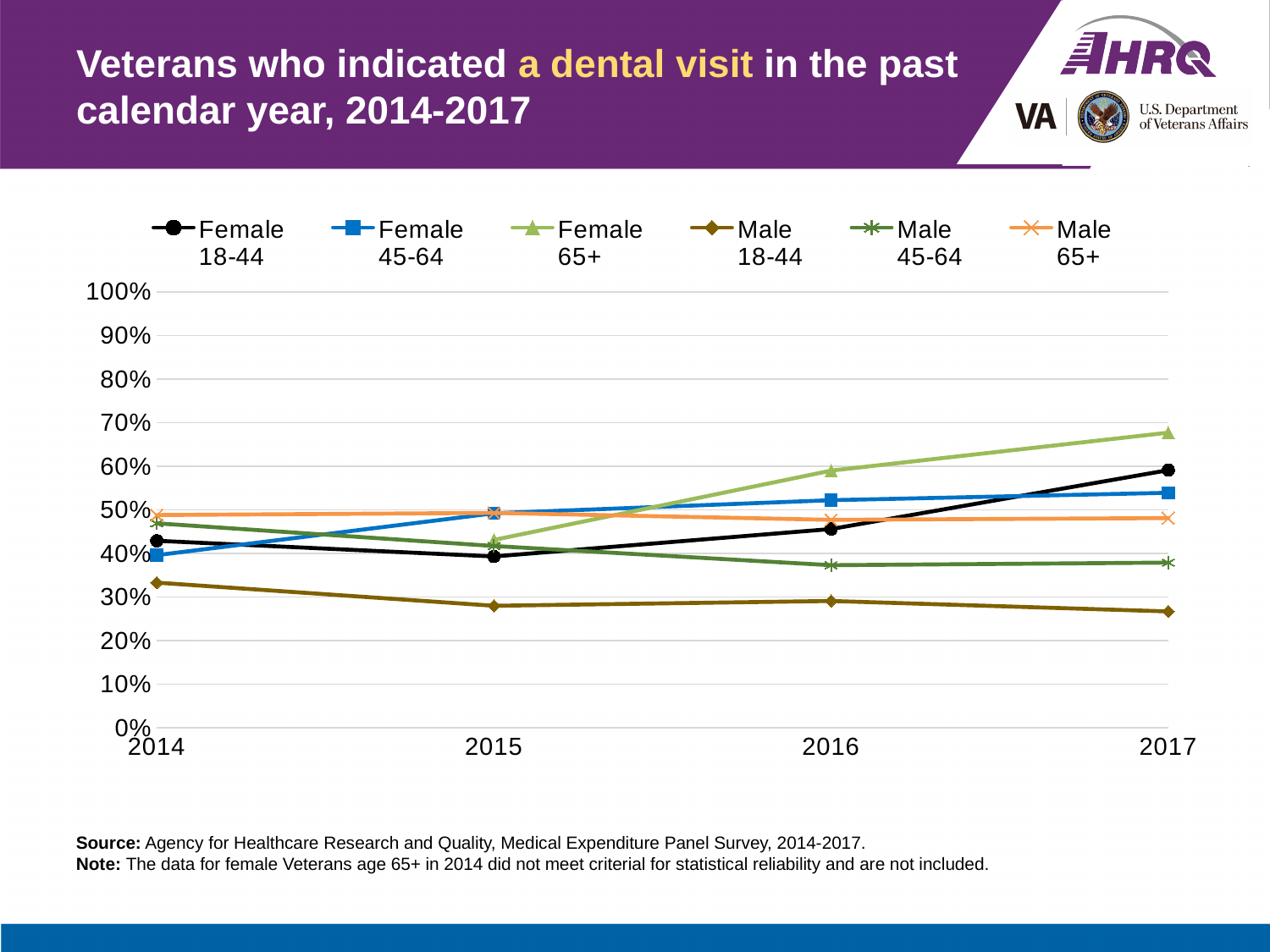
Is the value for Female 65+ in 2017 greater or less than 60%? greater How many series does the legend list? 6 How many years are shown on the x axis? 4 Is the value for Male 18-44 in 2014 greater or less than 40%? less Which series has the highest value in 2017? Female 65+ Which series has the lowest value in 2017? Male 18-44 In 2016, which is larger: the value for Female 65+ or the value for Male 45-64? Female 65+ Does the Male 18-44 line rise or fall from 2014 to 2017? fall What kind of chart is shown on the slide? line chart Does the Female 65+ line rise or fall from 2015 to 2017? rise Which series has no data point plotted for 2014? Female 65+ Is the value for Female 45-64 in 2017 greater or less than 50%? greater